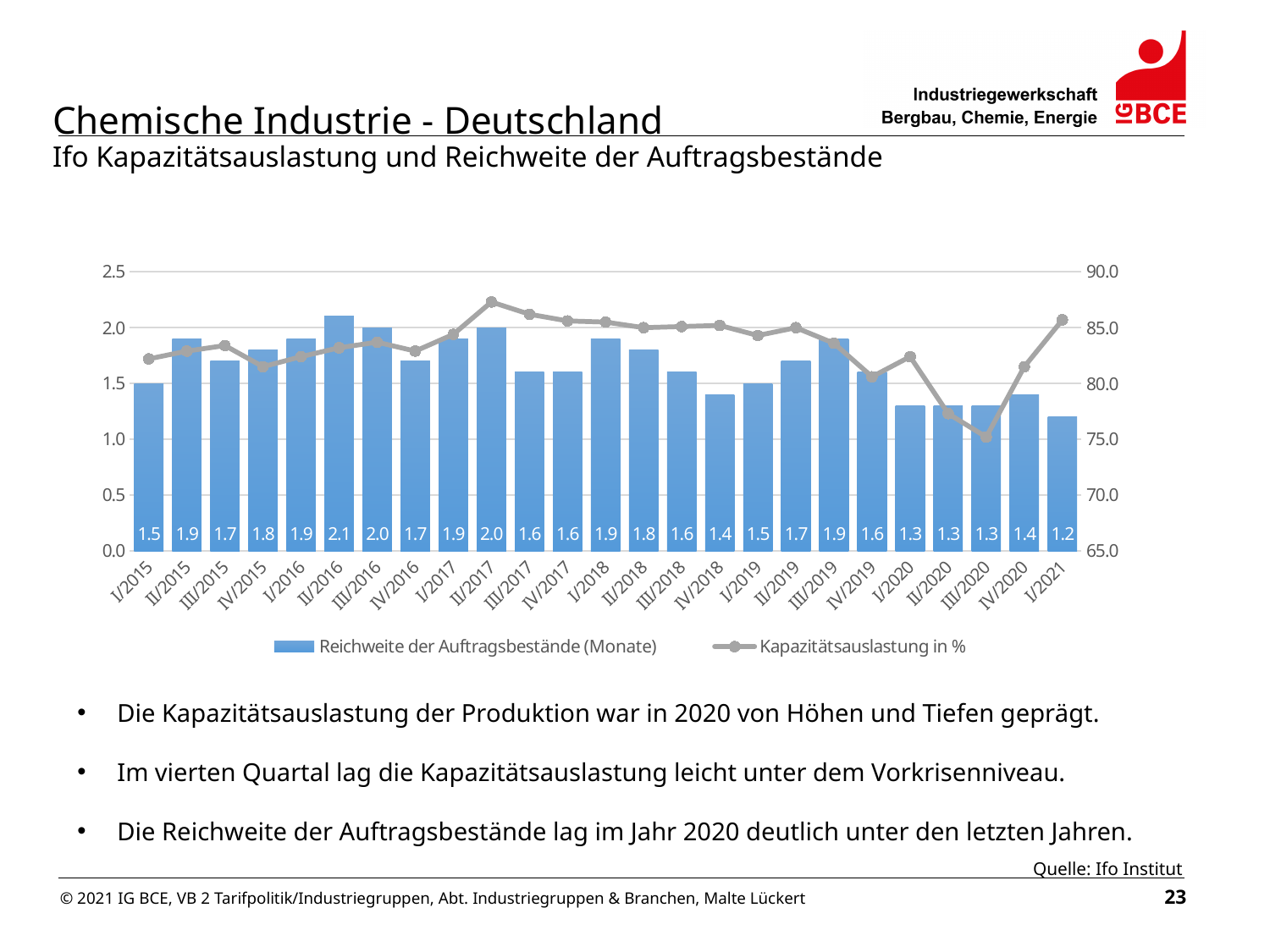
Which quarter has the highest Reichweite der Auftragsbestände (Monate)? II/2016 What is the difference in Reichweite der Auftragsbestände (Monate) between II/2016 and I/2021? 0.9 How many quarters are shown on the x axis? 25 What is the value of Reichweite der Auftragsbestände (Monate) for II/2016? 2.1 Is the Kapazitätsauslastung in % for II/2017 greater or less than 85.0? greater Which quarter has the lowest Reichweite der Auftragsbestände (Monate)? I/2021 Which quarter has a higher Reichweite der Auftragsbestände (Monate), I/2018 or IV/2019? I/2018 What is the value of Reichweite der Auftragsbestände (Monate) for I/2021? 1.2 Which series is plotted as a line with markers? Kapazitätsauslastung in % Is the Kapazitätsauslastung in % for III/2020 greater or less than 80.0? less What is the value of Reichweite der Auftragsbestände (Monate) for IV/2018? 1.4 How many series does the legend list? 2